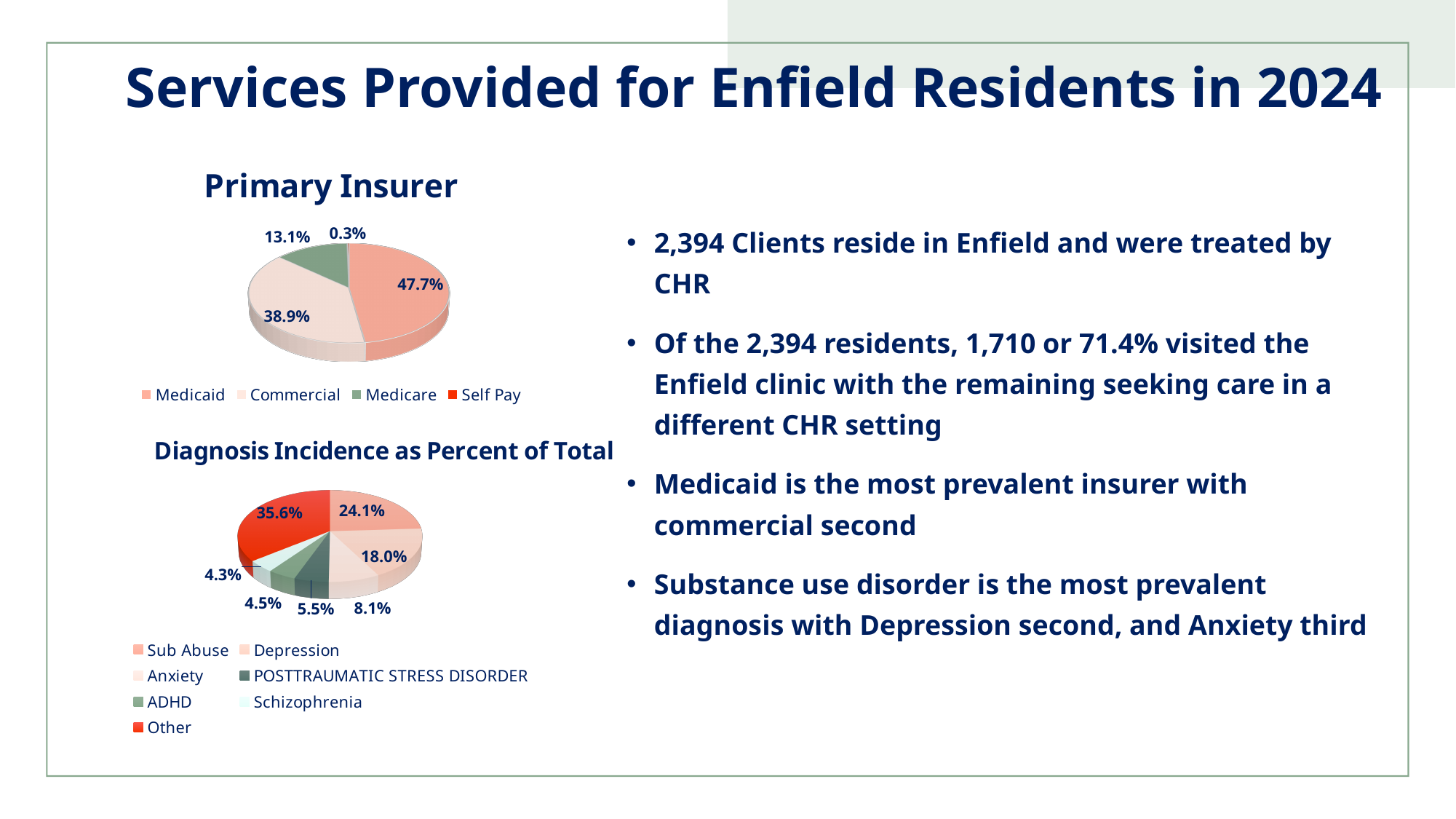
In the Primary Insurer chart, which insurer has the smallest share? Self Pay In the Primary Insurer chart, what percentage is shown for Commercial? 38.9% In the Diagnosis Incidence as Percent of Total chart, which is larger, Anxiety or POSTTRAUMATIC STRESS DISORDER? Anxiety In the Diagnosis Incidence as Percent of Total chart, what percentage is shown for Other? 35.6% In the Diagnosis Incidence as Percent of Total chart, what is the difference in percentage points between Sub Abuse and Depression? 6.1 In the Diagnosis Incidence as Percent of Total chart, which diagnosis category has the largest share? Other In the Primary Insurer chart, what percentage is shown for Medicaid? 47.7% In the Diagnosis Incidence as Percent of Total chart, how many categories does the legend list? 7 In the Diagnosis Incidence as Percent of Total chart, what percentage is shown for Depression? 18.0% In the Primary Insurer chart, what is the difference in percentage points between Medicaid and Commercial? 8.8 What type of chart is the Primary Insurer chart? Pie chart In the Primary Insurer chart, how many categories does the legend list? 4